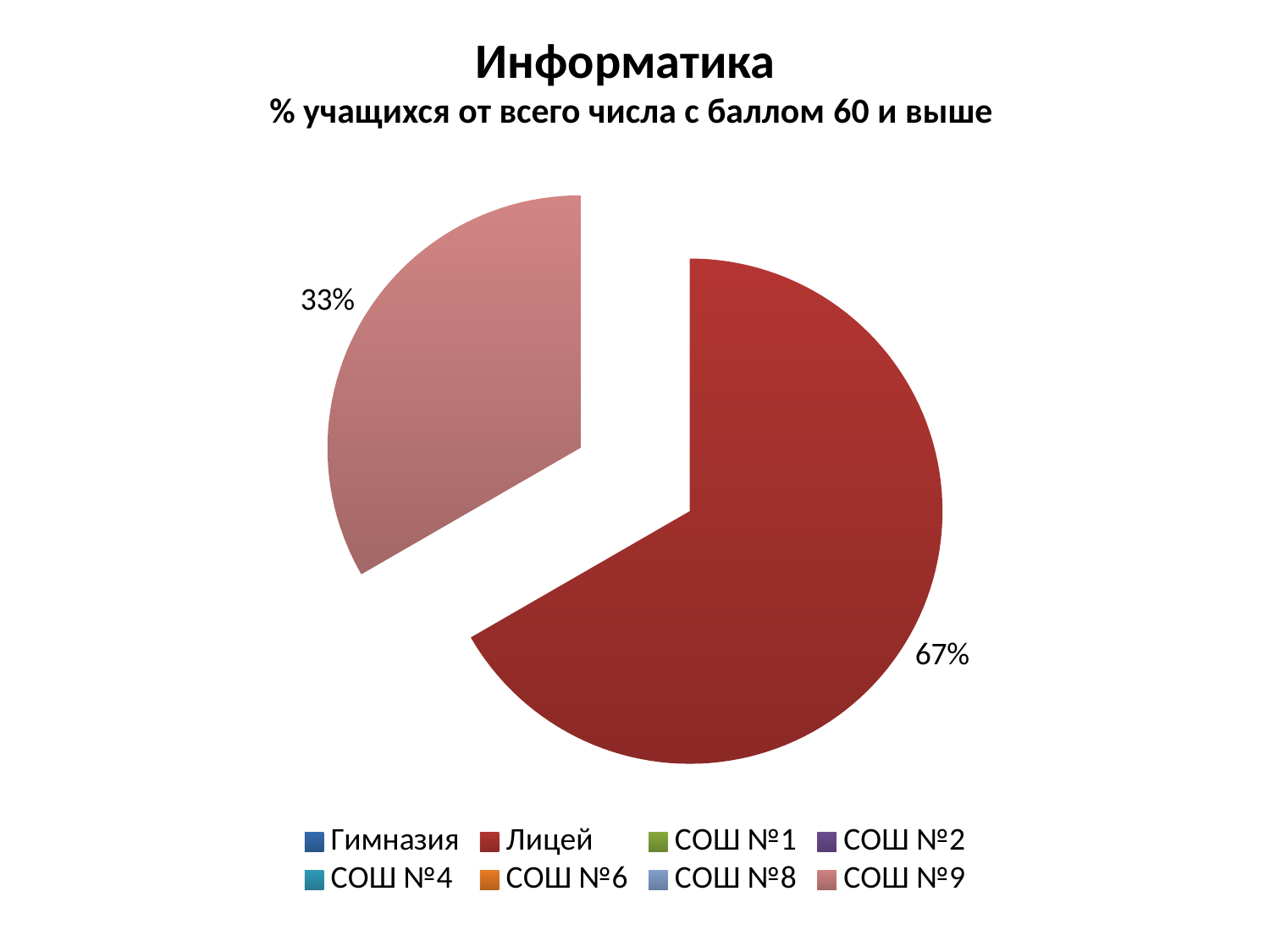
Is the share for Лицей greater or less than 50%? greater What share of the pie does Лицей have? 67% What is the subtitle shown under the chart title? % учащихся от всего числа с баллом 60 и выше What is the difference in percentage points between the Лицей slice and the СОШ №9 slice? 34 What is the title of the chart? Информатика What share of the pie does СОШ №9 have? 33% Which is larger, the slice for Лицей or the slice for СОШ №9? Лицей Which of the two visible slices is the smallest? СОШ №9 How many slices with a visible share are shown in the pie? 2 How many entries does the legend list? 8 What kind of chart is shown on the slide? pie chart Which school has the largest slice of the pie? Лицей